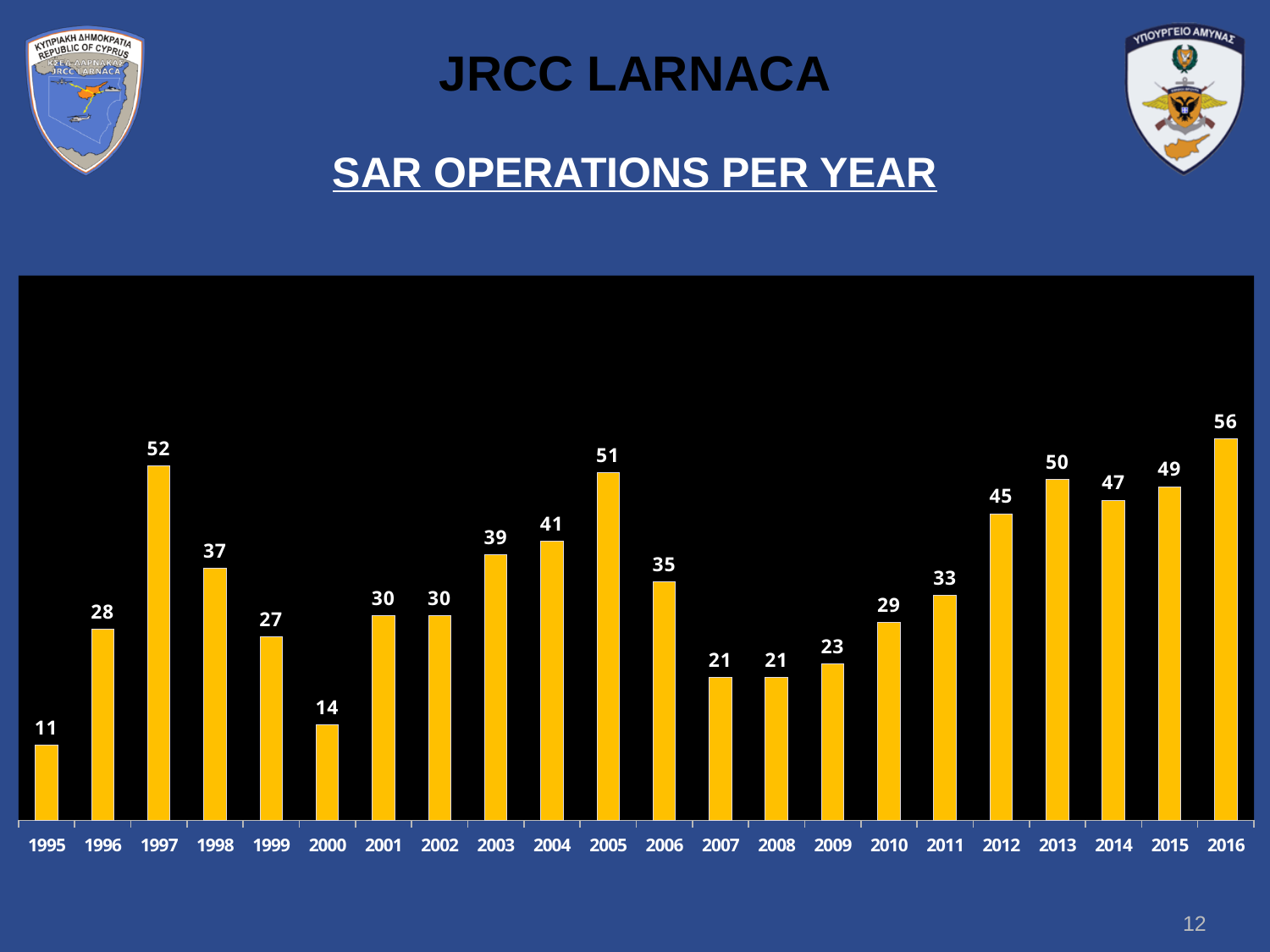
Which year has a larger value, 2013 or 2014? 2013 What kind of chart is shown on the slide? Bar chart What is the value shown for 2000? 14 Do the values rise or fall from 2009 to 2016? Rise Which year has a larger value, 2006 or 2011? 2006 What is the title of the chart? SAR OPERATIONS PER YEAR How many years are shown on the x axis? 22 Which year has the lowest number of SAR operations? 1995 How many SAR operations were there in 2005? 51 What is the difference between the values for 1997 and 1998? 15 Which year has the highest number of SAR operations? 2016 What is the difference between the values for 2016 and 1995? 45